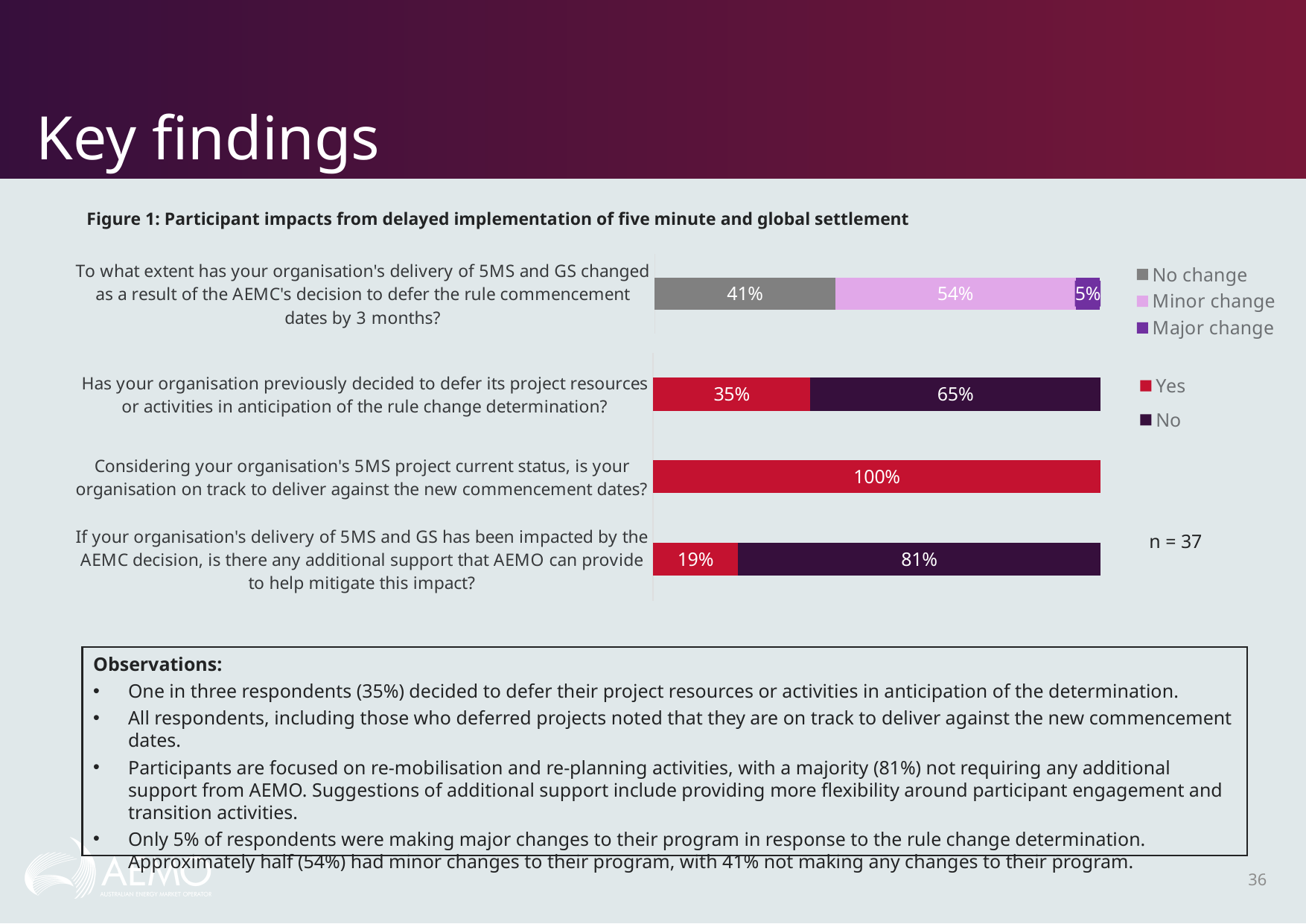
Which response category is the smallest for the question about the extent of change in delivery of 5MS and GS? Major change For the question about additional support from AEMO, which is larger: the Yes share or the No share? No What is the difference between the No and Yes percentages for the question about previously deferring project resources or activities? 30% What type of chart is shown in Figure 1? Stacked bar chart What percentage of respondents reported no change in their delivery of 5MS and GS? 41% How many survey questions are plotted in the chart? 4 What percentage of respondents reported a major change in their delivery of 5MS and GS? 5% What percentage of organisations answered Yes to having previously decided to defer project resources or activities in anticipation of the rule change determination? 35% What percentage of organisations said they are on track to deliver against the new commencement dates? 100% What percentage of organisations answered No to whether additional support from AEMO is needed to help mitigate the impact? 81% Which response category is the largest for the question about the extent of change in delivery of 5MS and GS? Minor change What percentage of respondents reported a minor change in their delivery of 5MS and GS as a result of the AEMC's decision? 54%